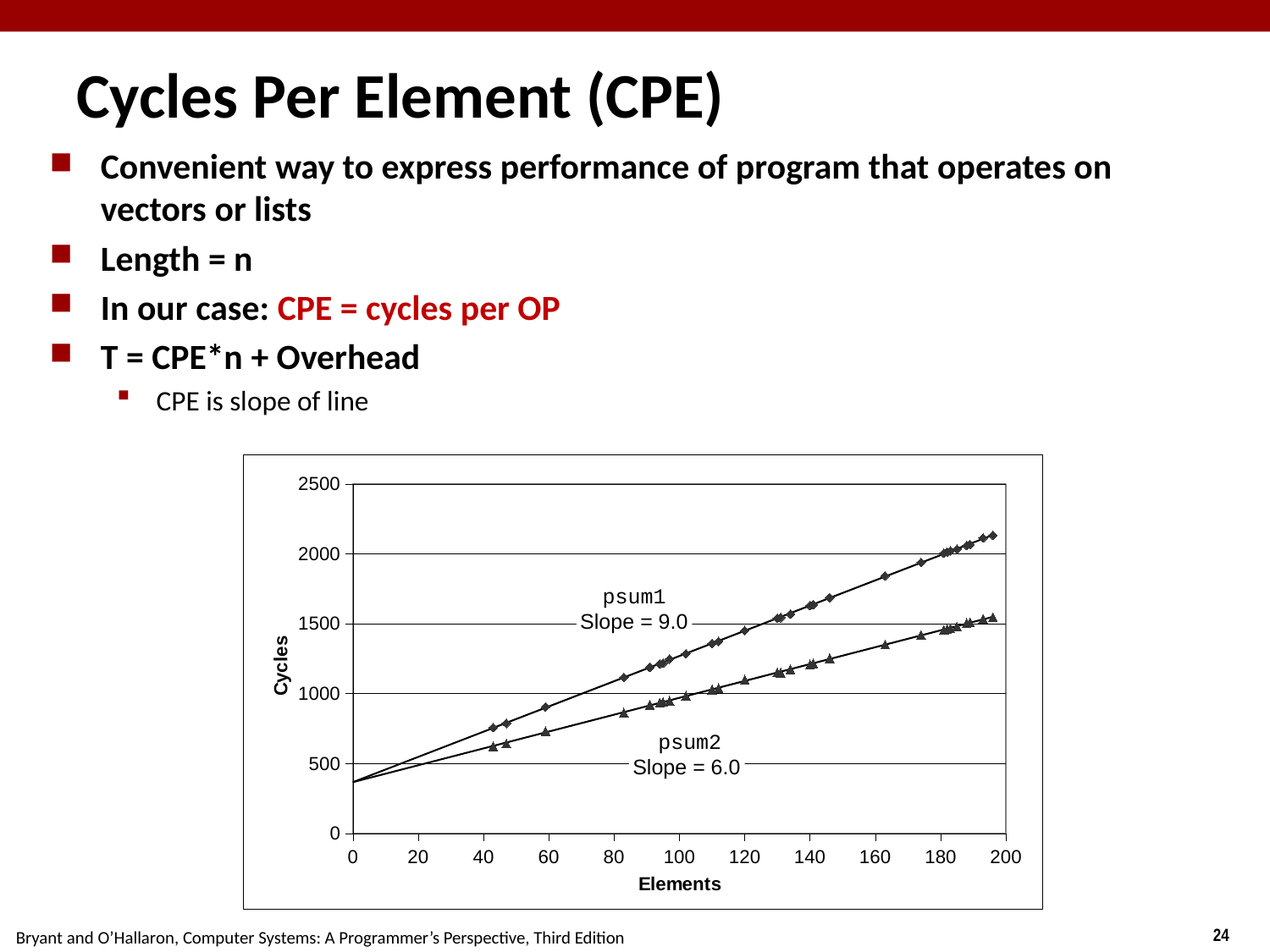
Which series has the larger slope, psum1 or psum2? psum1 What kind of chart is shown on the slide? scatter plot with fitted lines What is the highest tick value shown on the y axis of the chart? 2500 What slope is printed on the chart for the psum1 series? Slope = 9.0 What slope is printed on the chart for the psum2 series? Slope = 6.0 Is the value for psum2 at about 195 elements greater or less than 2000 cycles? less How many data series are plotted on the chart? 2 Do the cycle counts for psum1 rise or fall as the number of elements increases? rise What is the label of the x axis of the chart? Elements Is the value for psum1 at about 195 elements greater or less than 2000 cycles? greater At around 180 elements, which series has more cycles, psum1 or psum2? psum1 What is the label of the y axis of the chart? Cycles